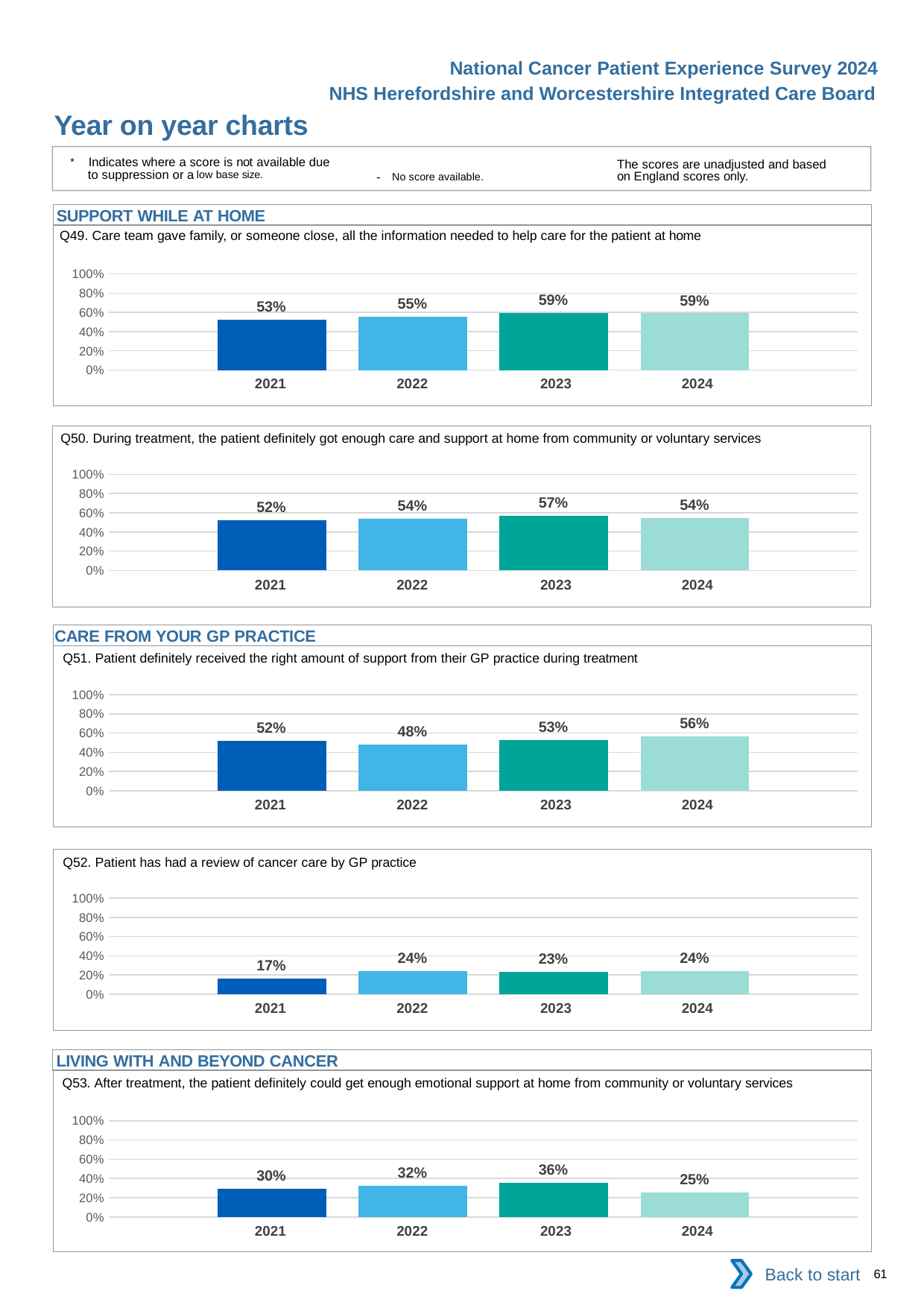
In the Q53 chart, which is larger, the value for 2023 or the value for 2024? 2023 What kind of chart is the Q53 chart? bar chart In the Q52 chart, is the value for 2021 greater or less than 20%? less In the Q50 chart, which year has the highest value? 2023 In the Q52 chart, what is the difference between the 2022 value and the 2021 value? 7% In the Q51 chart, which year has the lowest value? 2022 In the Q50 chart, what is the value for 2021? 52% How many years are shown in the Q49 chart? 4 In the Q53 chart, what is the difference between the 2023 value and the 2024 value? 11% In the Q51 chart, what is the value for 2024? 56% In the Q49 chart, what is the value for 2022? 55% Which section heading appears above the Q53 chart? LIVING WITH AND BEYOND CANCER